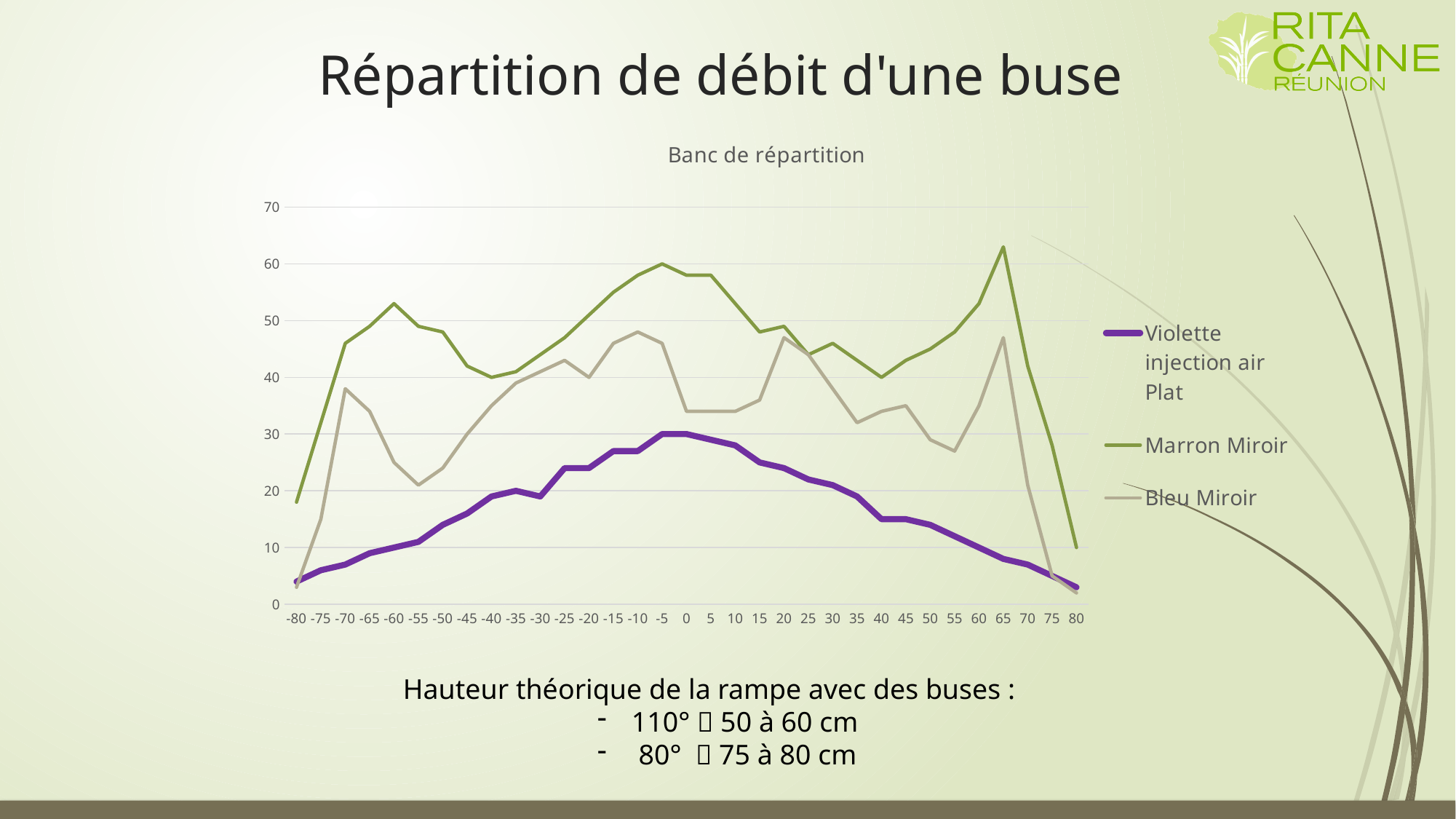
Is the value of Violette injection air Plat at x = 0 greater or less than 20? greater What is the title of the chart? Banc de répartition What kind of chart is shown on the slide? line chart At which x-axis position does the Marron Miroir series reach its lowest value? 80 At which x-axis position does the Marron Miroir series reach its highest value? 65 At x = 0, which series has the larger value, Marron Miroir or Violette injection air Plat? Marron Miroir Is the value of Bleu Miroir at x = 65 greater or less than 40? greater What is the value of Marron Miroir at x = -5? 60 How many points are there along the x axis of the chart? 33 How many series does the legend list? 3 Does the Violette injection air Plat series rise or fall from x = 0 to x = 80? fall Is the value of Marron Miroir at x = -80 greater or less than 30? less